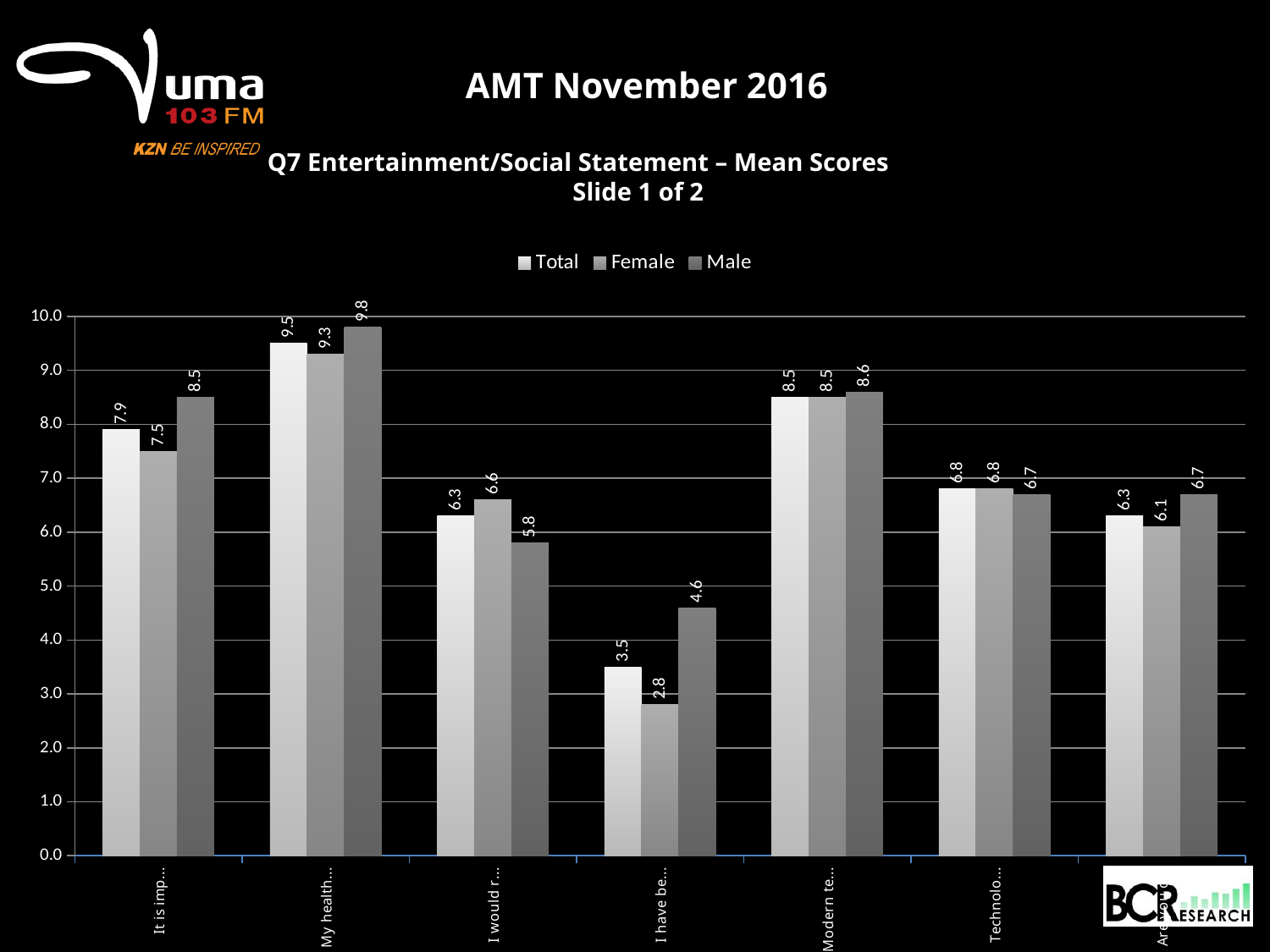
Is the Female mean score for the category labelled 'I would r...' greater or less than 6.0? greater For the category labelled 'It is imp...', which is larger: the Total score or the Male score? Male What is the Female mean score for the category labelled 'I have be...'? 2.8 How many series does the legend list? 3 What kind of chart is shown on the slide? bar chart For the category labelled 'I have be...', what is the difference between the Male and Female mean scores? 1.8 What is the Total mean score for the category labelled 'Modern te...'? 8.5 How many categories (groups of bars) are plotted on the chart? 7 What are the series names listed in the legend? Total, Female, Male Which category has the highest Total mean score? My health... Which category has the lowest Female mean score? I have be... What is the Male mean score for the category labelled 'My health...'? 9.8